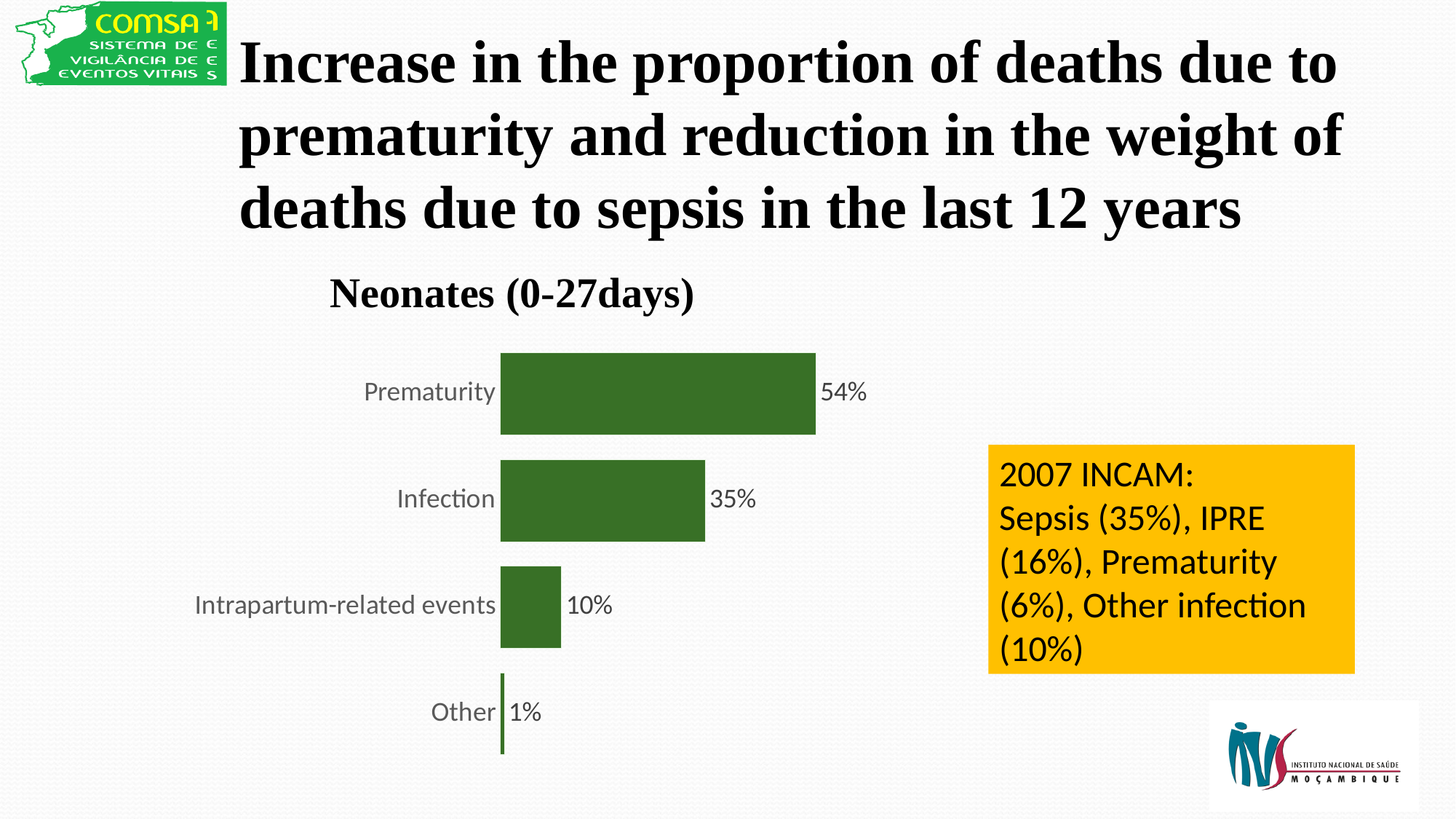
Which category has the lowest value? Other Which is larger, the value for Infection or the value for Intrapartum-related events? Infection What kind of chart is shown on the slide? Bar chart What is the value for Intrapartum-related events? 10% What is the value for Prematurity? 54% What is the difference between the values for Infection and Intrapartum-related events? 25% What is the value for Infection? 35% What is the title of the chart? Neonates (0-27days) What is the value for Other? 1% What is the difference between the values for Prematurity and Infection? 19% Which category has the highest value? Prematurity How many categories are shown in the chart? 4